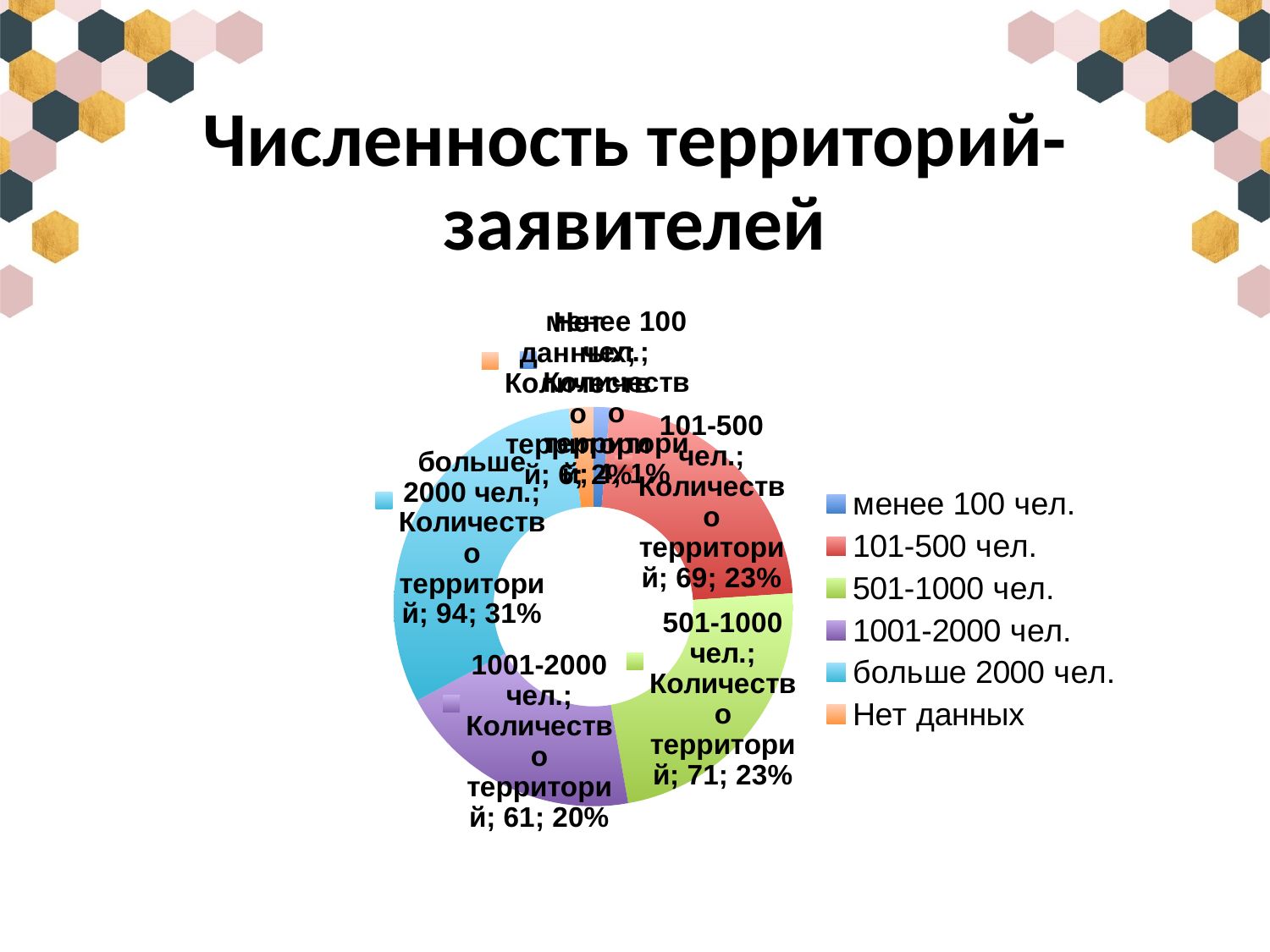
Which category has the largest share of the chart? больше 2000 чел. What percentage share does the category 'больше 2000 чел.' have? 31% What is the difference in the number of territories between '501-1000 чел.' and '101-500 чел.'? 2 What is the number of territories for the category '1001-2000 чел.'? 61 What kind of chart is shown on the slide? Doughnut (pie) chart Which category has more territories: 'больше 2000 чел.' or '1001-2000 чел.'? больше 2000 чел. What is the number of territories for the category 'больше 2000 чел.'? 94 What is the title of the slide with the chart? Численность территорий-заявителей How many categories does the legend list? 6 What percentage share does the category '1001-2000 чел.' have? 20% What is the number of territories for the category '501-1000 чел.'? 71 What is the number of territories for the category '101-500 чел.'? 69